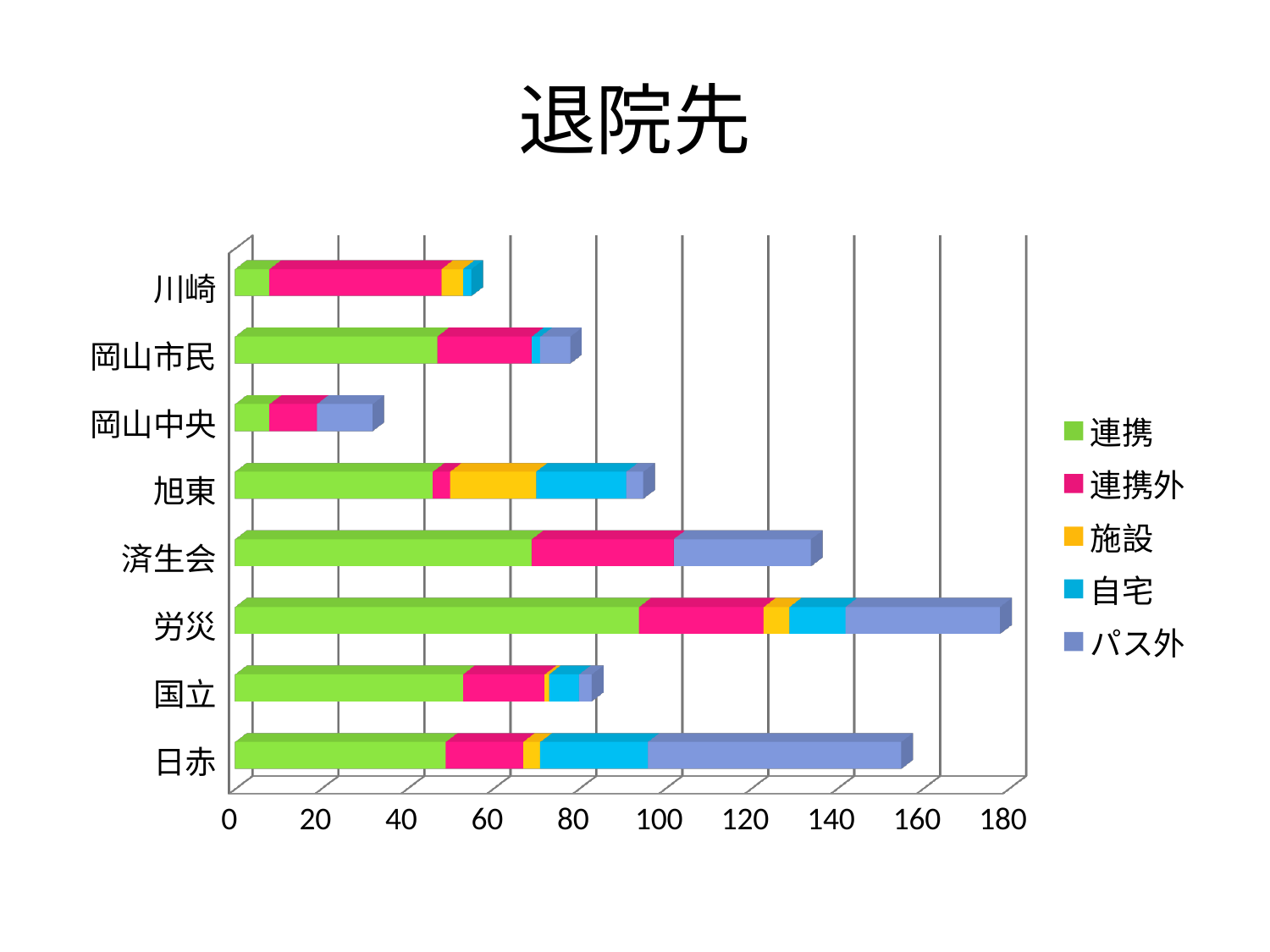
How many hospitals (categories) are shown on the chart? 8 How many series does the legend list? 5 Is the total bar length for 日赤 greater or less than 140? greater Is the total bar length for 労災 greater or less than 160? greater What kind of chart is shown on the slide? stacked bar chart What is the title of the chart? 退院先 Is the total bar length for 岡山中央 greater or less than 40? less Which has the longer total bar, 済生会 or 日赤? 日赤 Which hospital has the shortest total bar? 岡山中央 Which hospital has the largest 連携 segment? 労災 Which hospital has the longest total bar? 労災